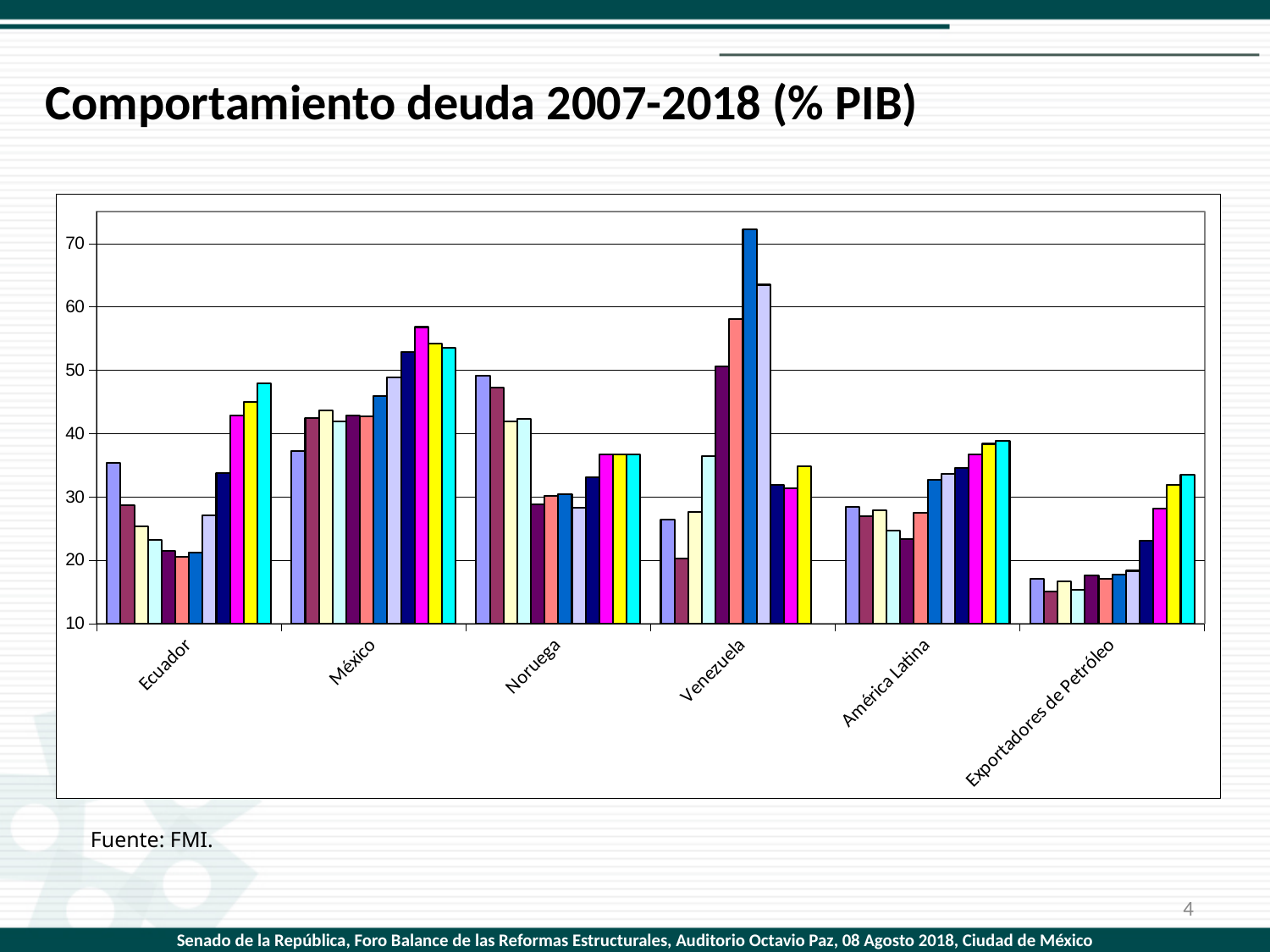
Is the tallest bar for América Latina greater or less than 40? less How many categories are shown on the x axis of the chart? 6 How many bars are plotted for each category in the chart? 12 What kind of chart is shown on the slide? bar chart Is the shortest bar for Exportadores de Petróleo greater or less than 20? less Which category contains the shortest bar in the chart? Exportadores de Petróleo Is the shortest bar for México greater or less than 30? greater What source is cited below the chart? FMI Which category contains the tallest bar in the chart? Venezuela What is the title of the slide containing the chart? Comportamiento deuda 2007-2018 (% PIB)